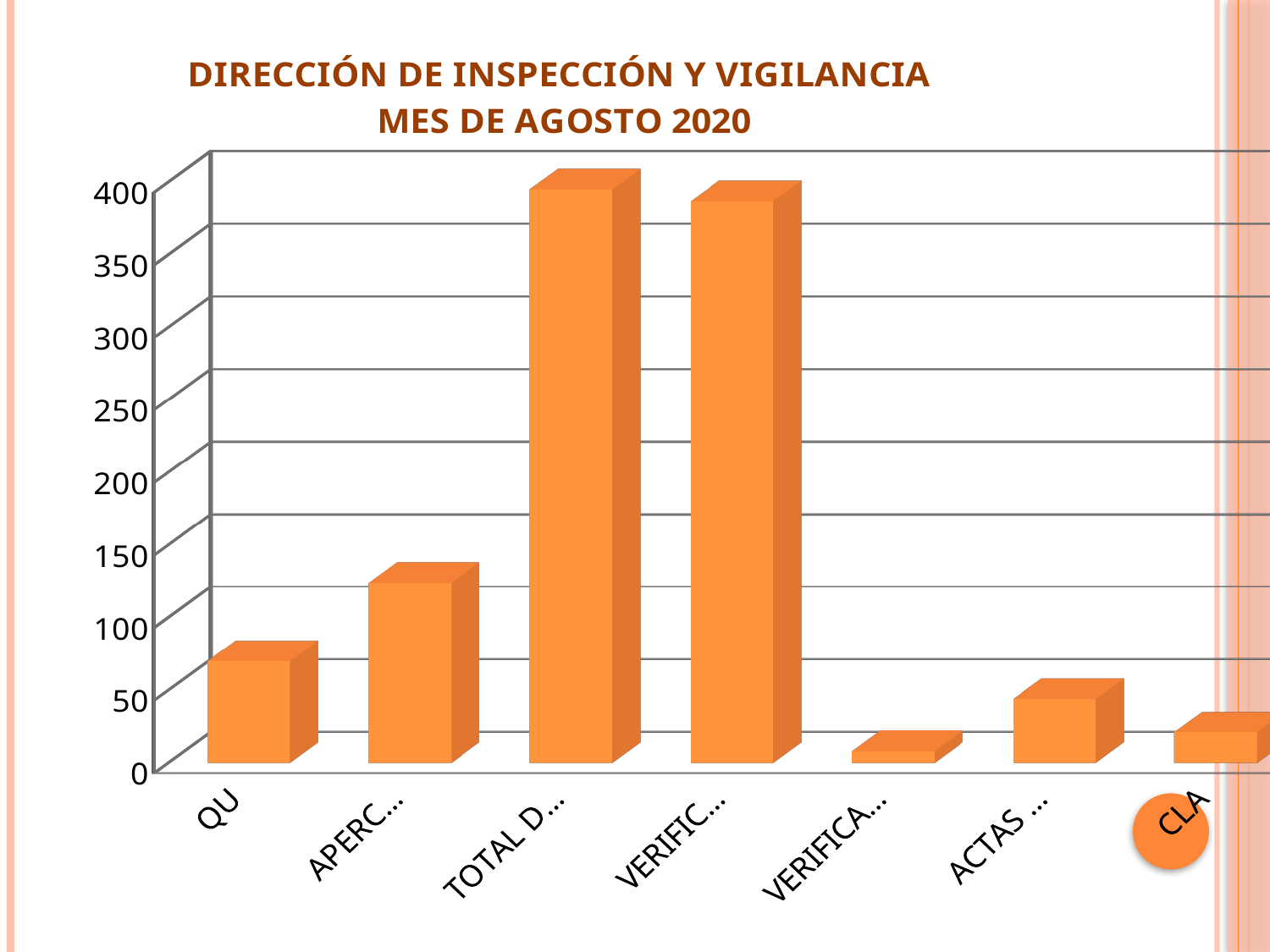
Is the value for TOTAL D... greater or less than 350? greater Is the value for APERC... greater or less than 100? greater Which has the larger value, QU or ACTAS ...? QU Is the value for ACTAS ... greater or less than 100? less What colour are the bars in the chart? Orange What kind of chart is shown on the slide? Bar chart What is the title of the chart? DIRECCIÓN DE INSPECCIÓN Y VIGILANCIA MES DE AGOSTO 2020 How many bars (categories) does the chart show? 7 Which category has the lowest value? VERIFICA... (fifth bar) Which has the larger value, QU or APERC...? APERC...